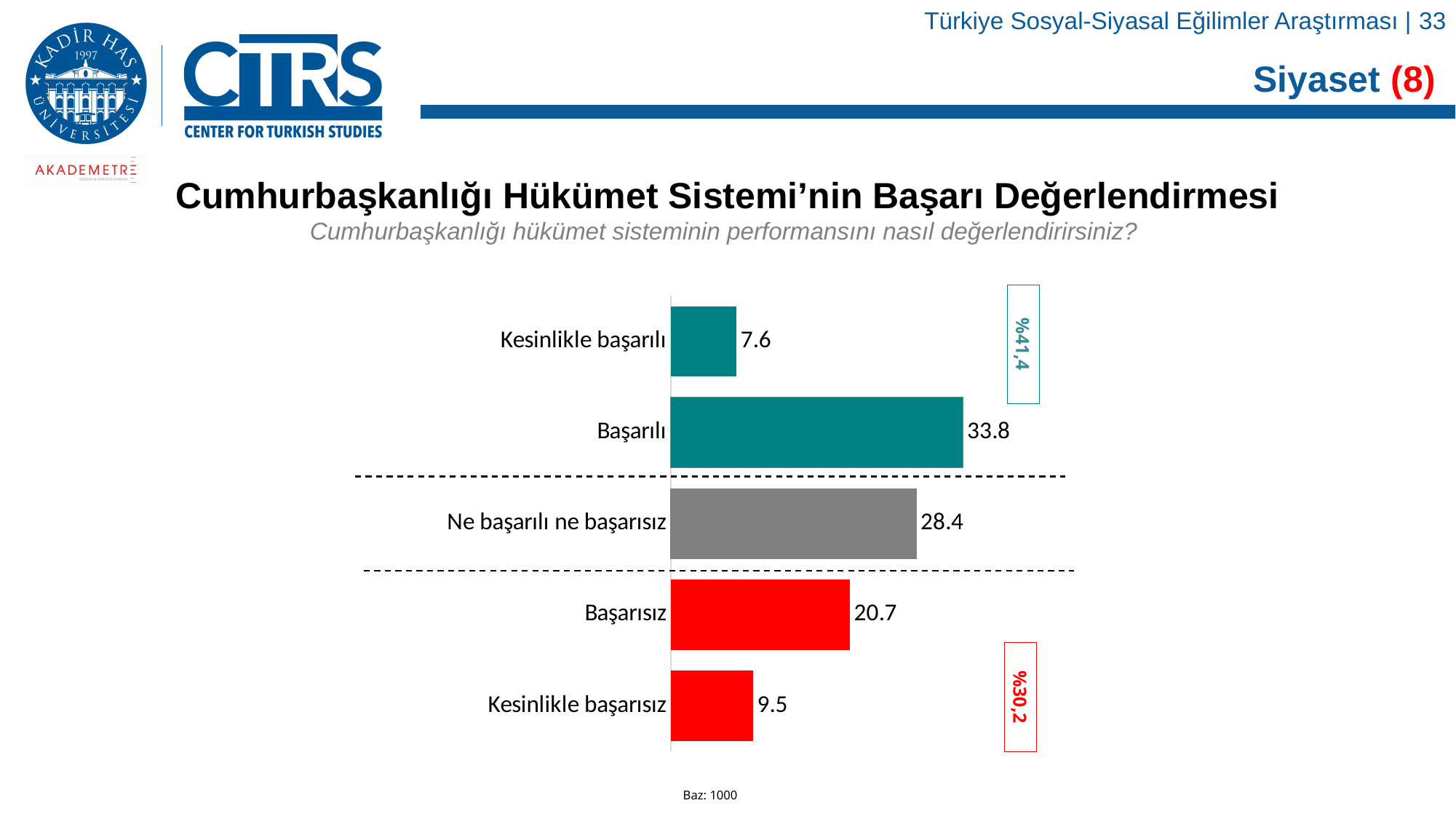
What is the difference between the values for "Kesinlikle başarısız" and "Kesinlikle başarılı"? 1.9 How many categories are shown in the chart? 5 Which category has the highest value? Başarılı Which is larger, the value for "Ne başarılı ne başarısız" or the value for "Başarısız"? Ne başarılı ne başarısız What is the value for "Kesinlikle başarısız"? 9.5 What base (Baz) is stated below the chart? 1000 What is the value for "Başarılı"? 33.8 Which category has the lowest value? Kesinlikle başarılı What is the value for "Ne başarılı ne başarısız"? 28.4 What is the difference between the values for "Başarılı" and "Başarısız"? 13.1 What combined percentage is shown in the box next to the teal bars? %41,4 What kind of chart is shown on the slide? Bar chart